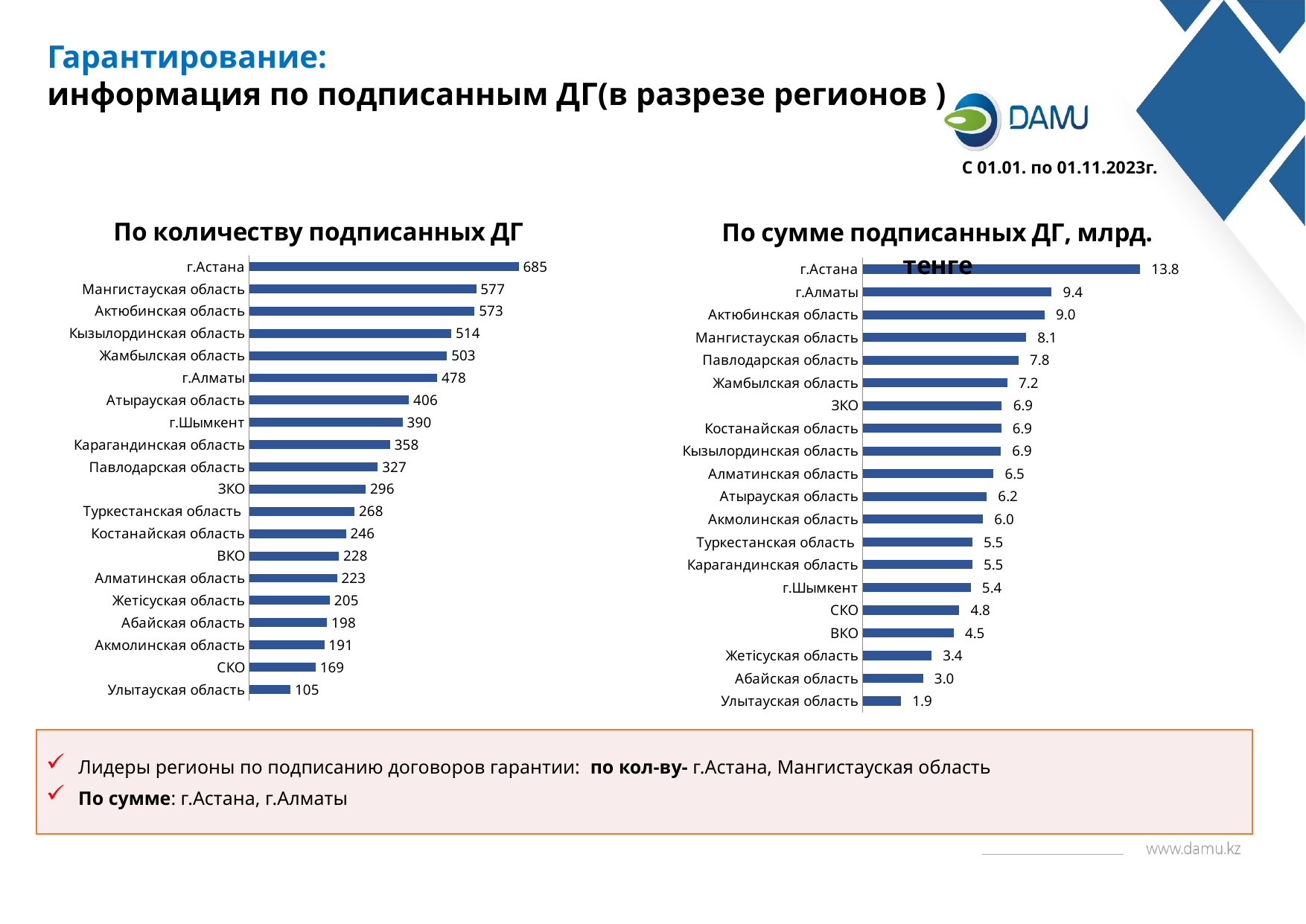
In the chart 'По сумме подписанных ДГ, млрд. тенге', what is the value for Павлодарская область? 7.8 What period is stated on the slide for the data? С 01.01. по 01.11.2023г. In the chart 'По количеству подписанных ДГ', what is the value for Кызылординская область? 514 What kind of chart is 'По сумме подписанных ДГ, млрд. тенге'? bar chart How many regions are shown in the chart 'По количеству подписанных ДГ'? 20 In the chart 'По количеству подписанных ДГ', which is larger: Атырауская область or г.Шымкент? Атырауская область In the chart 'По сумме подписанных ДГ, млрд. тенге', which region has the lowest value? Улытауская область In the chart 'По количеству подписанных ДГ', what is the value for г.Алматы? 478 In the chart 'По сумме подписанных ДГ, млрд. тенге', which is larger: СКО or ВКО? СКО In the chart 'По количеству подписанных ДГ', which region has the highest value? г.Астана In the chart 'По количеству подписанных ДГ', what is the difference between г.Астана and Мангистауская область? 108 In the chart 'По сумме подписанных ДГ, млрд. тенге', what is the difference between г.Астана and г.Алматы? 4.4